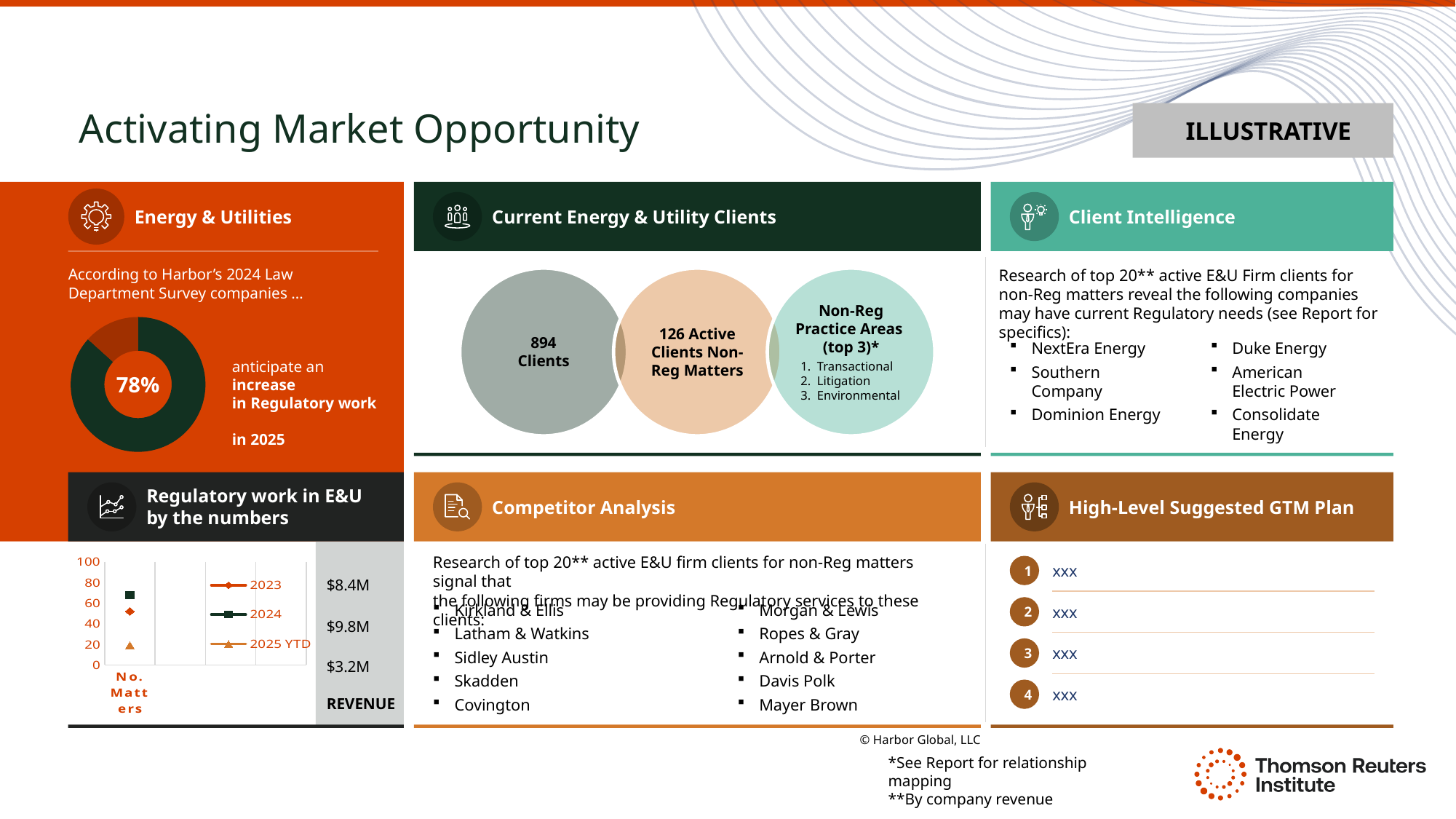
What share is shown in the donut chart in the 'Energy & Utilities' panel? 78% What are the legend entries of the 'Regulatory work in E&U by the numbers' chart? 2023, 2024, 2025 YTD In the 'Regulatory work in E&U by the numbers' chart, which series has the highest value for No. Matters? 2024 How many series does the legend of the 'Regulatory work in E&U by the numbers' chart list? 3 In the 'Regulatory work in E&U by the numbers' chart, which is larger for No. Matters: 2023 or 2025 YTD? 2023 What kind of chart is shown under the heading 'Regulatory work in E&U by the numbers'? line chart In the 'Regulatory work in E&U by the numbers' chart, which series has the lowest value for No. Matters? 2025 YTD How many categories are shown on the x axis of the 'Regulatory work in E&U by the numbers' chart? 1 In the 'Regulatory work in E&U by the numbers' chart, is the value for 2023 greater or less than 80? less In the 'Regulatory work in E&U by the numbers' chart, is the value for 2025 YTD greater or less than 40? less In the 'Regulatory work in E&U by the numbers' chart, is the value for 2024 greater or less than 60? greater What is the highest tick value on the y axis of the 'Regulatory work in E&U by the numbers' chart? 100